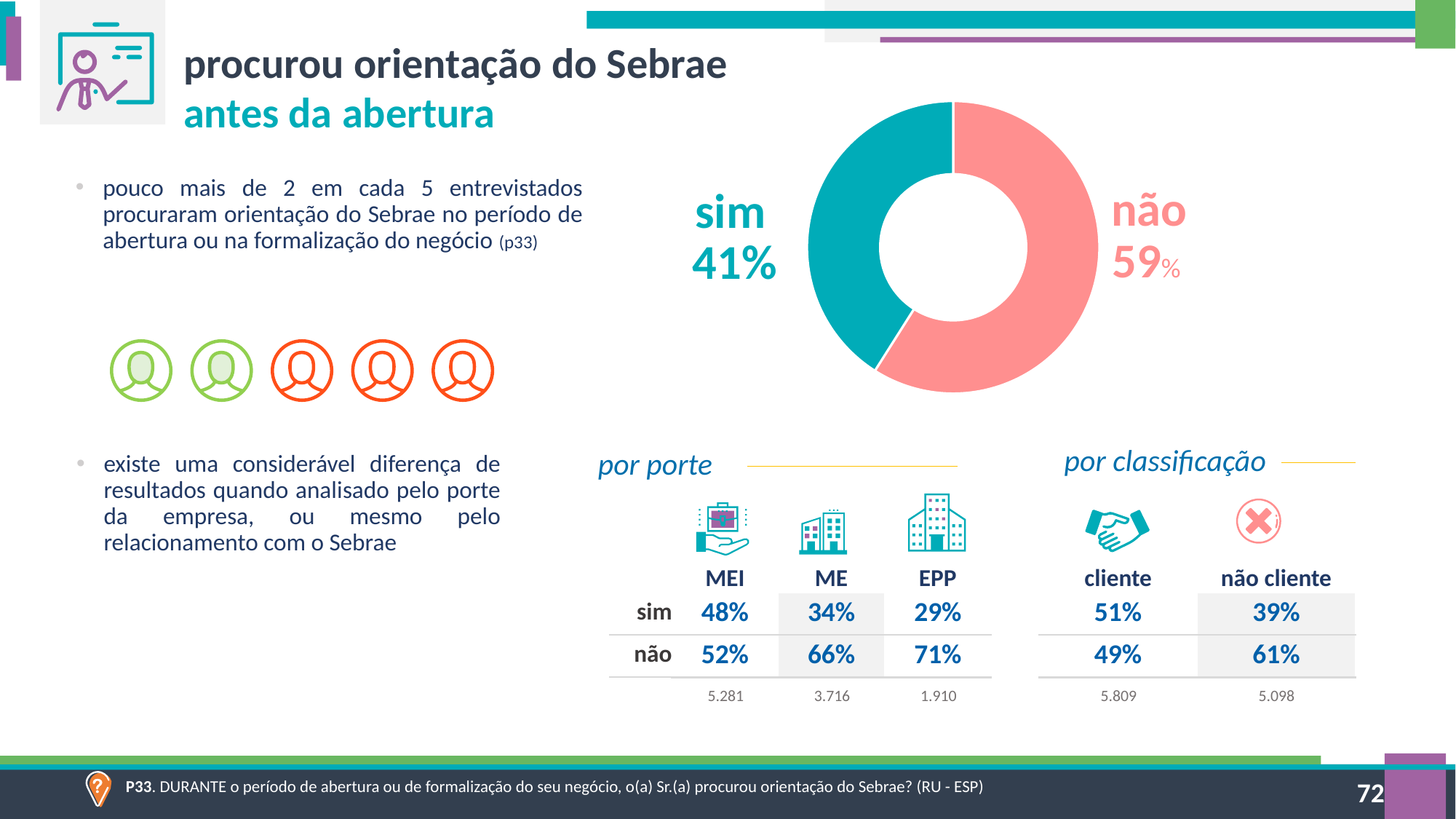
In the donut chart, which slice is larger, "sim" or "não"? não In the "por porte" table, which company size has the highest "não" percentage? EPP In the donut chart, what colour is the "sim" slice? Teal In the donut chart, what percentage of respondents answered "sim"? 41% In the donut chart, what is the difference in percentage points between "não" and "sim"? 18 percentage points In the "por classificação" table, what percentage of "não cliente" respondents answered "sim"? 39% What kind of chart is shown at the top right of the slide? Donut (pie) chart In the "por porte" table, what percentage of MEI respondents answered "sim"? 48% In the donut chart, what percentage of respondents answered "não"? 59% In the donut chart, what colour is the "não" slice? Pink/salmon In the donut chart, which category has the smallest share? sim How many slices does the donut chart have? 2